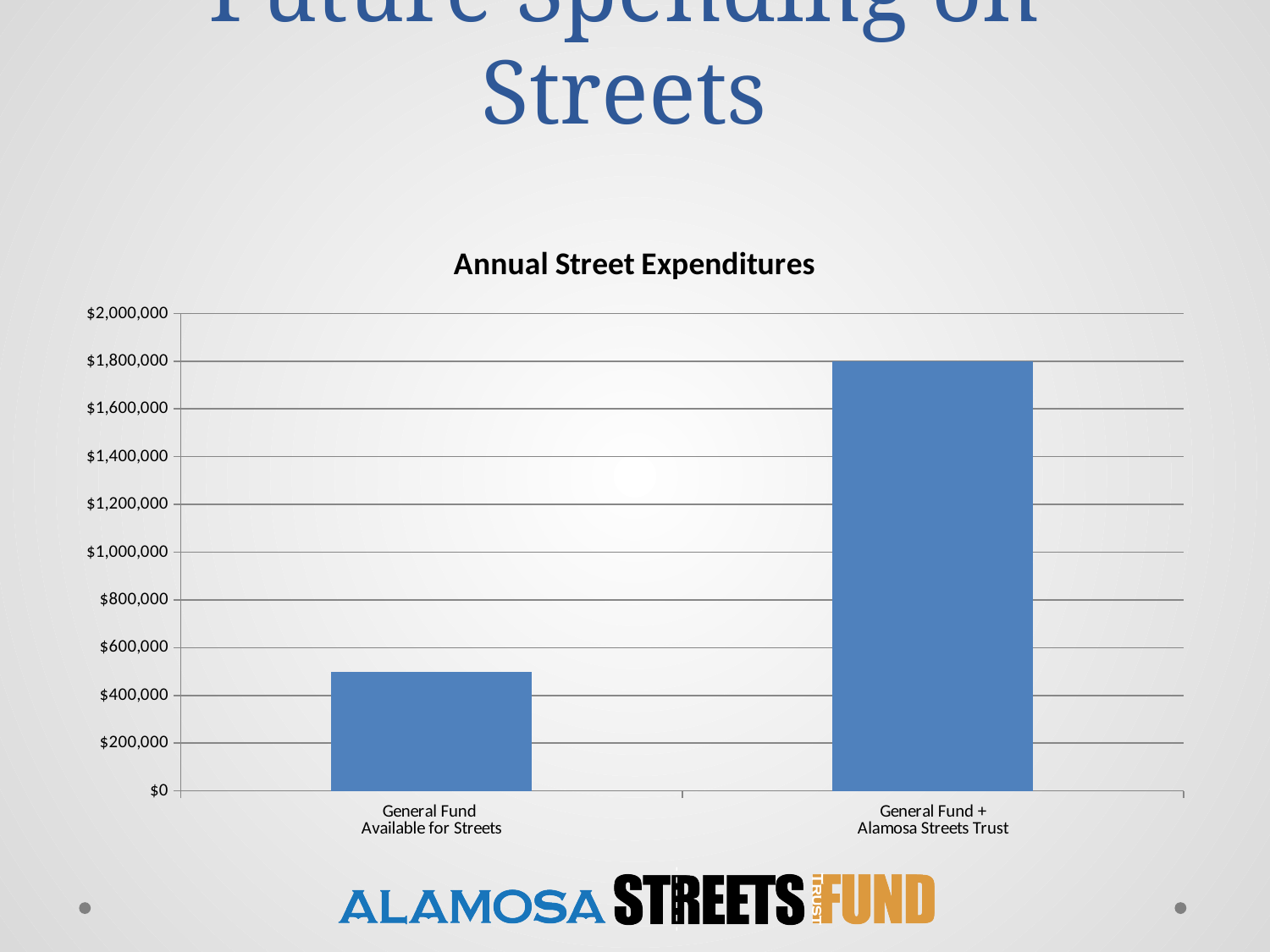
What is the title of the chart on the slide? Annual Street Expenditures What is the highest value shown on the vertical axis of the "Annual Street Expenditures" chart? $2,000,000 Which is larger: the value for "General Fund Available for Streets" or the value for "General Fund + Alamosa Streets Trust"? General Fund + Alamosa Streets Trust How many bars are plotted in the "Annual Street Expenditures" chart? 2 Is the value for "General Fund Available for Streets" greater or less than $400,000? greater Is the value for "General Fund + Alamosa Streets Trust" greater or less than $1,000,000? greater What is the value for "General Fund + Alamosa Streets Trust" in the "Annual Street Expenditures" chart? $1,800,000 Is the value for "General Fund Available for Streets" greater or less than $600,000? less What kind of chart is shown under the title "Annual Street Expenditures"? bar chart Which category has the highest value in the "Annual Street Expenditures" chart? General Fund + Alamosa Streets Trust Which category has the lowest value in the "Annual Street Expenditures" chart? General Fund Available for Streets